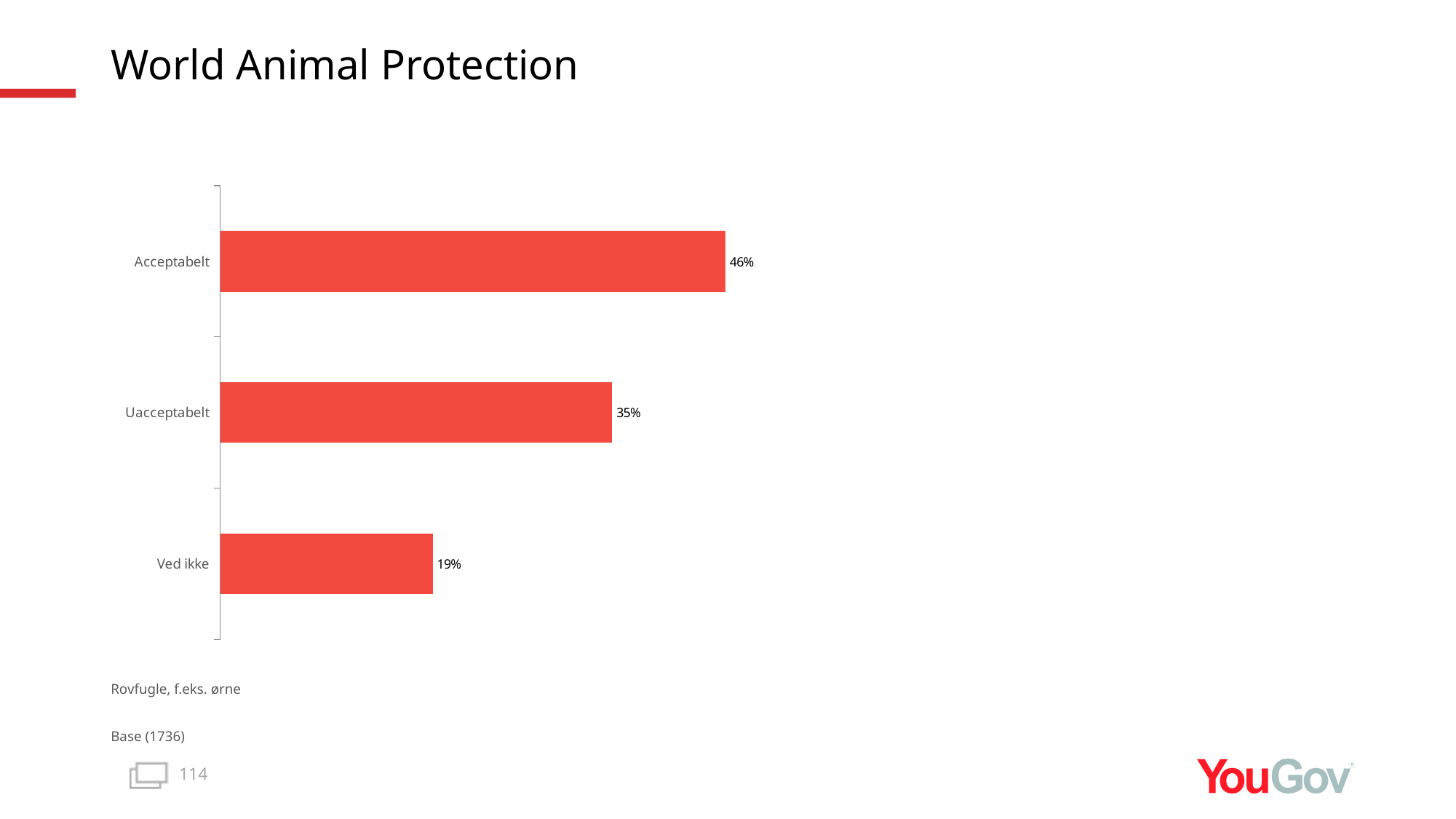
Which category has the highest value? Acceptabelt Which category has the lowest value? Ved ikke What is the difference between the values for Acceptabelt and Uacceptabelt? 11 percentage points What is the difference between the values for Uacceptabelt and Ved ikke? 16 percentage points What percentage is shown for Uacceptabelt? 35% What percentage is shown for Ved ikke? 19% How many categories are shown in the chart? 3 What base size is stated below the chart? 1736 What percentage is shown for Acceptabelt? 46% What type of chart is shown on the slide? Bar chart Which is larger, the value for Uacceptabelt or the value for Ved ikke? Uacceptabelt What is the title of the slide? World Animal Protection